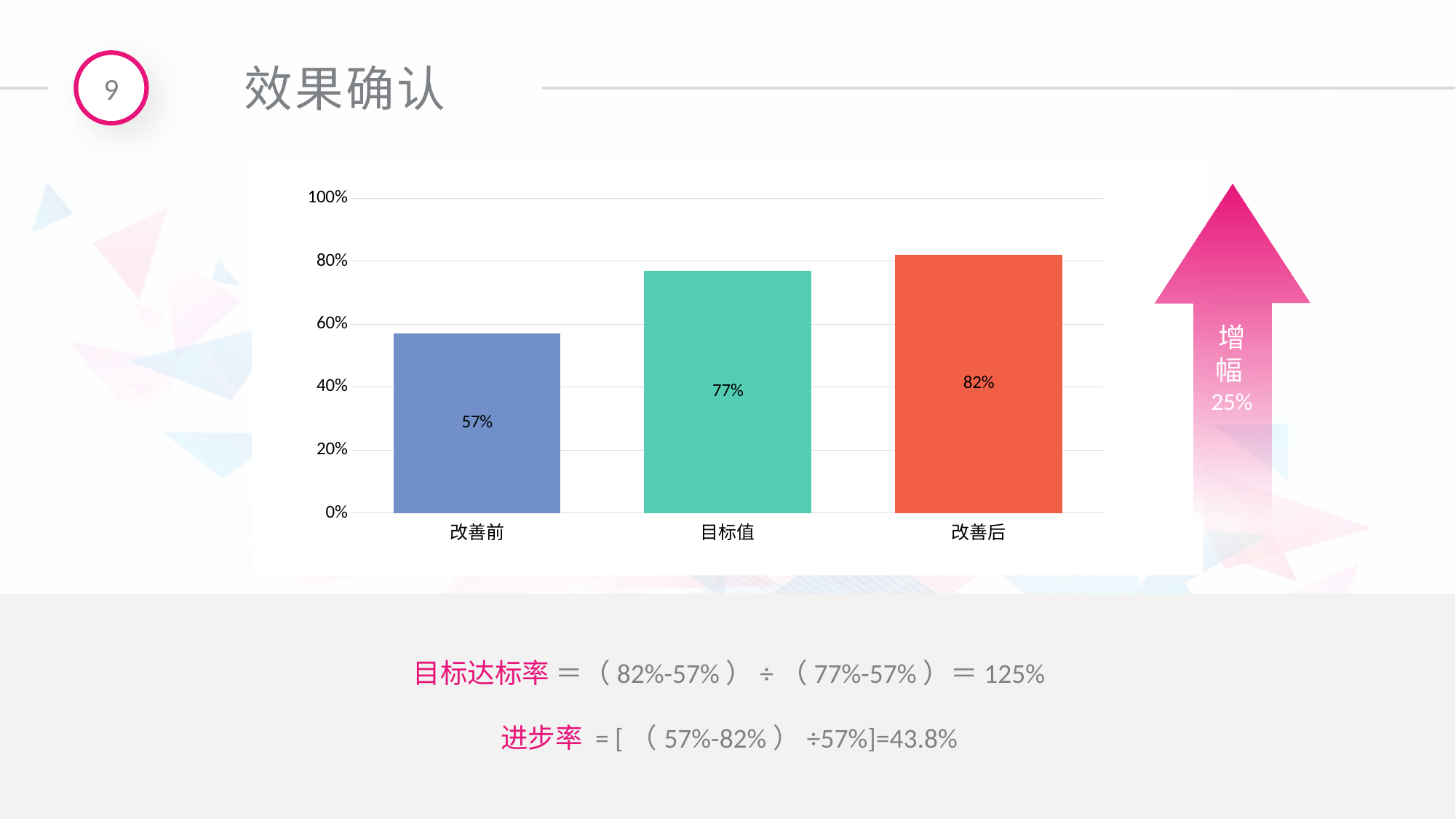
What is the value for 改善前? 57% What is the value for 目标值? 77% Which is larger, the value for 改善后 or the value for 目标值? 改善后 What is the value for 改善后? 82% Which category has the highest value? 改善后 How many categories are shown on the x axis? 3 What is the difference between the values for 目标值 and 改善前? 20% What kind of chart is shown on the slide? bar chart Do the values rise or fall from left to right along the x axis? rise Is the value for 改善前 greater or less than 60%? less Which category has the lowest value? 改善前 What is the difference between the values for 改善后 and 改善前? 25%